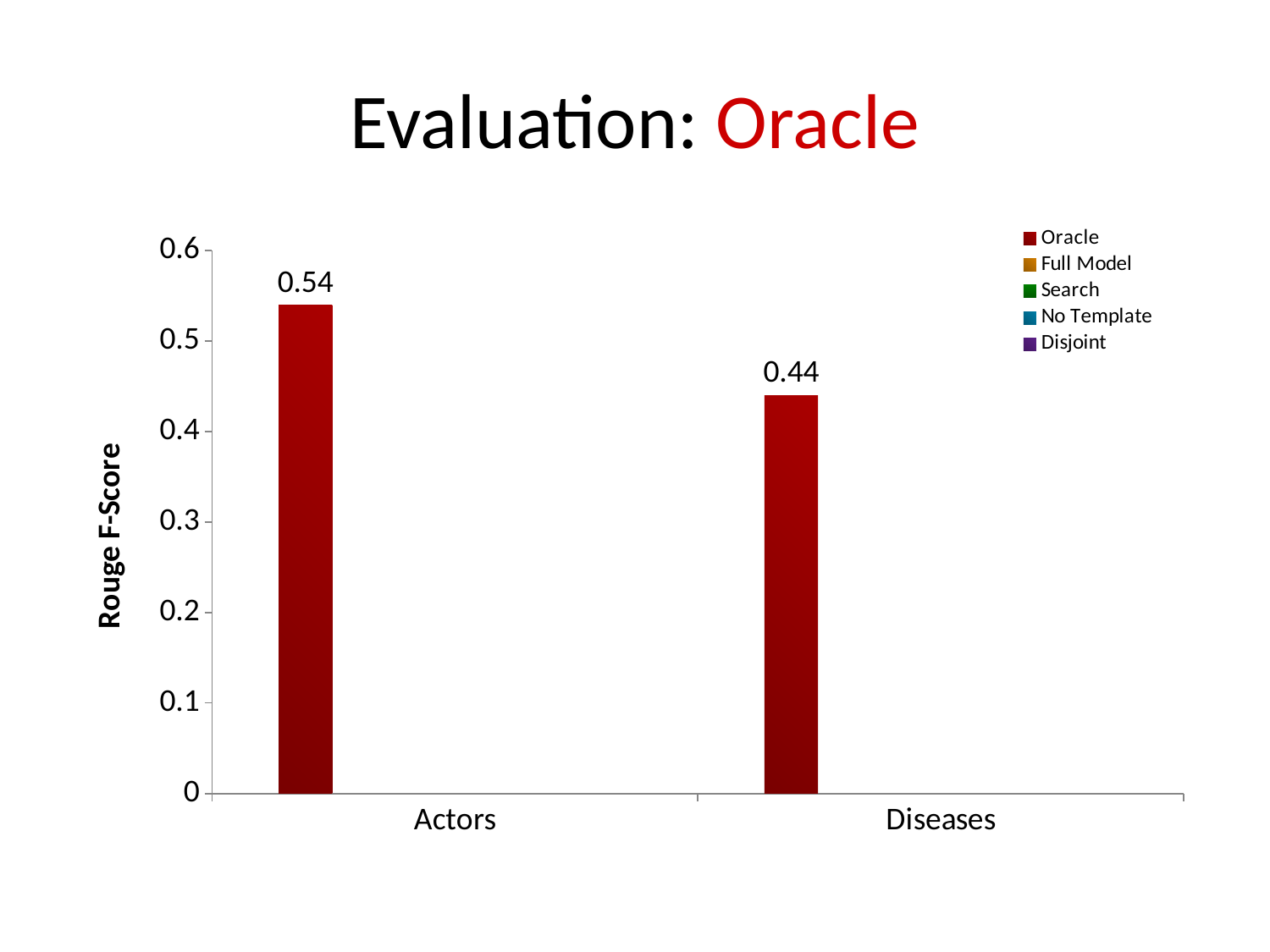
What is the Oracle Rouge F-Score for Diseases? 0.44 Is the Oracle value for Diseases greater or less than 0.5? less Which category has the higher Oracle Rouge F-Score? Actors What kind of chart is shown on the slide? bar chart How many series does the legend list? 5 Is the Oracle value for Actors greater or less than 0.5? greater What is the difference between the Oracle Rouge F-Score for Actors and for Diseases? 0.10 What is the Oracle Rouge F-Score for Actors? 0.54 How many categories are shown on the x axis? 2 What is the label of the y axis? Rouge F-Score Which category has the lower Oracle Rouge F-Score? Diseases Is the Oracle Rouge F-Score larger for Actors or for Diseases? Actors